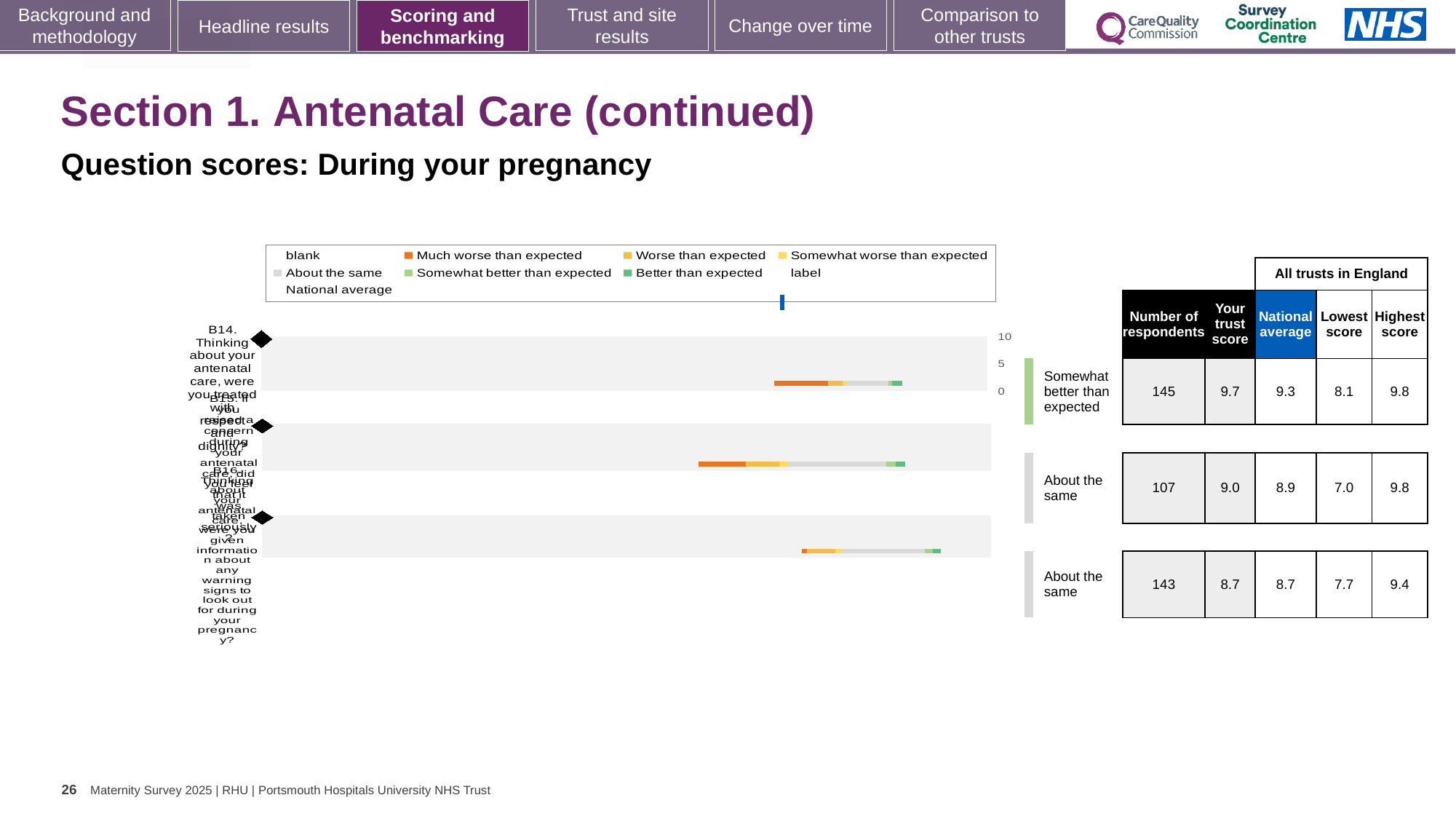
What benchmark rating label is shown next to the first bar (B14)? Somewhat better than expected Which row of the table has the highest 'Your trust score'? The first row (B14), 9.7 In the table, what is the 'Your trust score' for the first row (B14, treated with respect and dignity)? 9.7 For the second row, which is larger: 'Your trust score' or the national average? Your trust score (9.0) How many entries does the chart legend list? 9 What kind of chart is shown on the slide? Bar chart Which row of the table has the lowest 'Lowest score' value? The second row, 7.0 For the first row, what is the difference between 'Your trust score' and the national average? 0.4 In the table, what is the national average for the third row (B16, information about warning signs)? 8.7 In the table, what is the number of respondents for the second row? 107 In the table, what is the highest score for the first row? 9.8 How many bars (questions) are plotted in the chart? 3